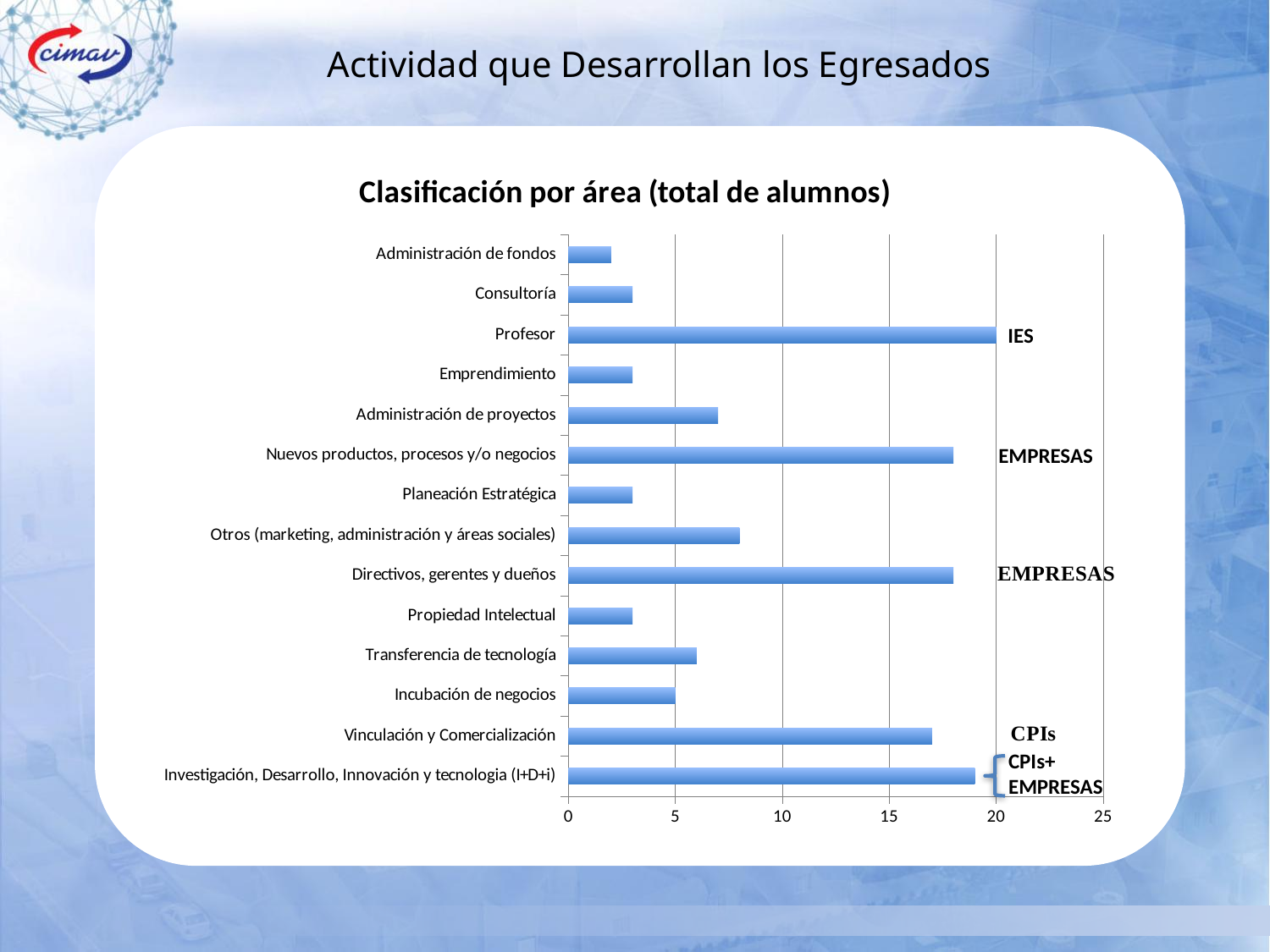
What label is written next to the Profesor bar? IES Which is larger, the value for Vinculación y Comercialización or the value for Transferencia de tecnología? Vinculación y Comercialización What is the value for Profesor? 20 What type of chart is shown on the slide? bar chart Is the value for Nuevos productos, procesos y/o negocios greater or less than 15? greater Which category has the highest value? Profesor Which category has the lowest value? Administración de fondos Is the value for Administración de proyectos greater or less than 5? greater How many categories are plotted in the chart? 14 Is the value for Otros (marketing, administración y áreas sociales) greater or less than 10? less What is the value for Incubación de negocios? 5 What is the title of the chart? Clasificación por área (total de alumnos)